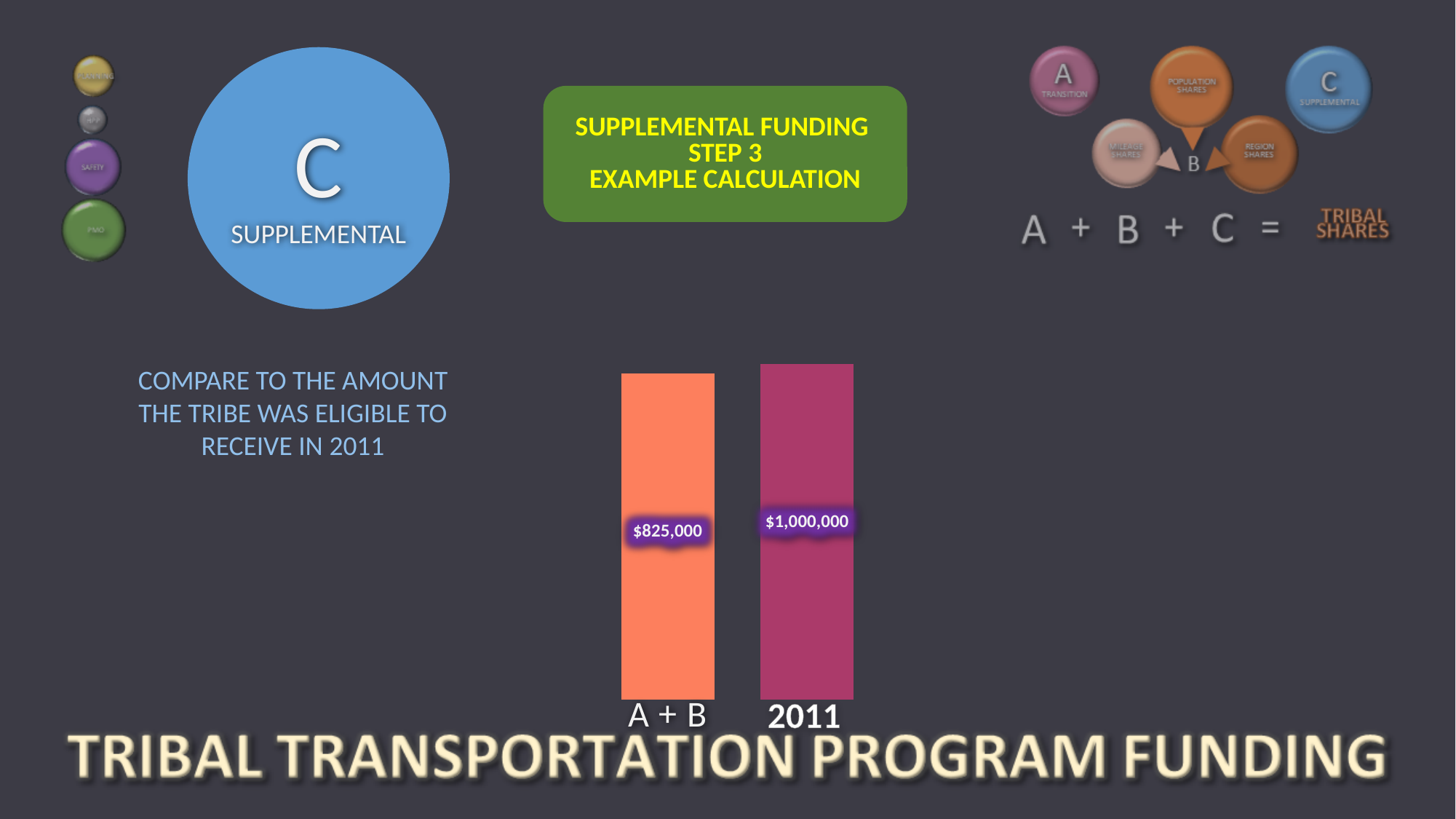
What colour is the 2011 bar? magenta What is the difference between the 2011 value and the A + B value? $175,000 What colour is the A + B bar? orange Which category has the highest value? 2011 What is the value shown for the 2011 bar? $1,000,000 Which bar is taller, A + B or 2011? 2011 What is the value shown for the A + B bar? $825,000 What kind of chart is shown on the slide? bar chart How many bars are shown in the chart? 2 Which category has the lowest value? A + B